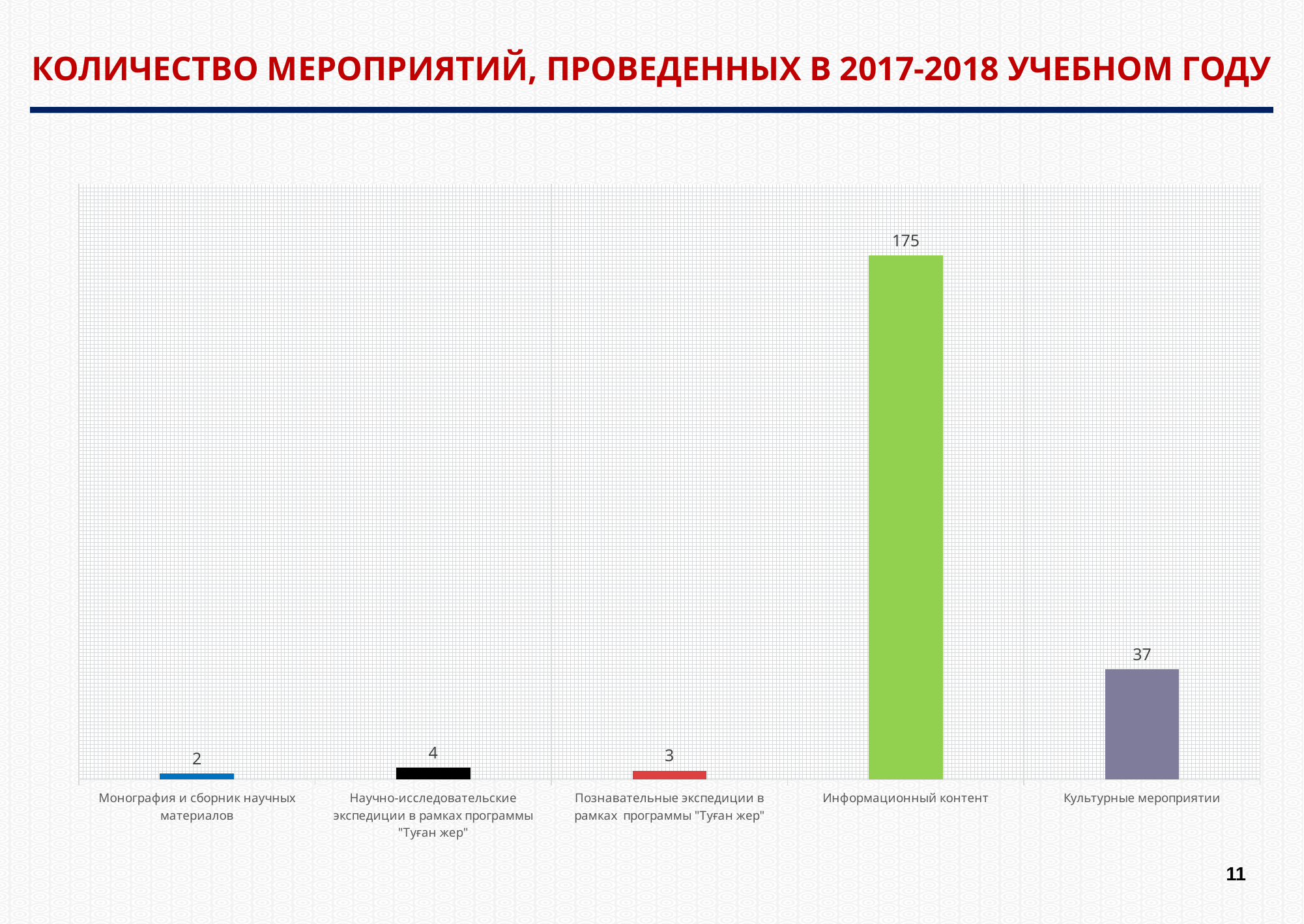
What is the title of the slide? КОЛИЧЕСТВО МЕРОПРИЯТИЙ, ПРОВЕДЕННЫХ В 2017-2018 УЧЕБНОМ ГОДУ What is the value for Монография и сборник научных материалов? 2 What kind of chart is shown on the slide? Bar chart What is the difference between the values for Информационный контент and Культурные мероприятии? 138 How many categories are shown in the chart? 5 What is the value for Культурные мероприятии? 37 What is the value for Научно-исследовательские экспедиции в рамках программы "Туған жер"? 4 What is the value for Познавательные экспедиции в рамках программы "Туған жер"? 3 Which category has the lowest value? Монография и сборник научных материалов Which is larger: the value for Научно-исследовательские экспедиции or the value for Познавательные экспедиции? Научно-исследовательские экспедиции What is the value for Информационный контент? 175 Which category has the highest value? Информационный контент